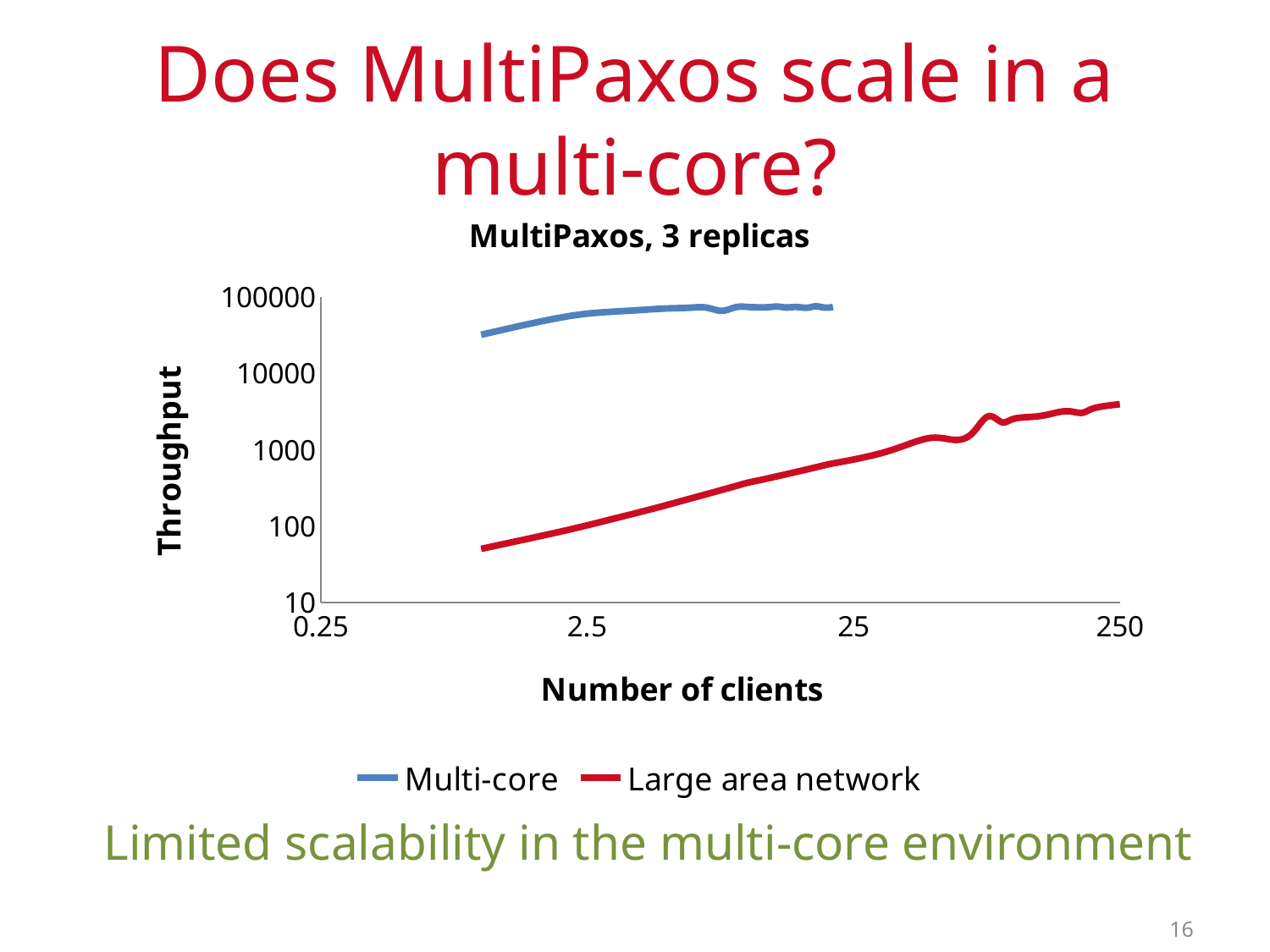
Is the throughput of the Multi-core series at its leftmost plotted point greater or less than 100000? less Is the throughput of the Large area network series at 250 clients greater or less than 10000? less Is the throughput of the Large area network series at 250 clients greater or less than 1000? greater What is the title of the chart? MultiPaxos, 3 replicas Which series reaches the lowest throughput value on the chart? Large area network How many series does the legend list? 2 What are the two series named in the legend? Multi-core and Large area network Does the throughput of the Large area network series rise or fall as the number of clients increases? Rise Which series has the higher throughput across the plotted range, Multi-core or Large area network? Multi-core What kind of chart is shown on the slide? Line chart